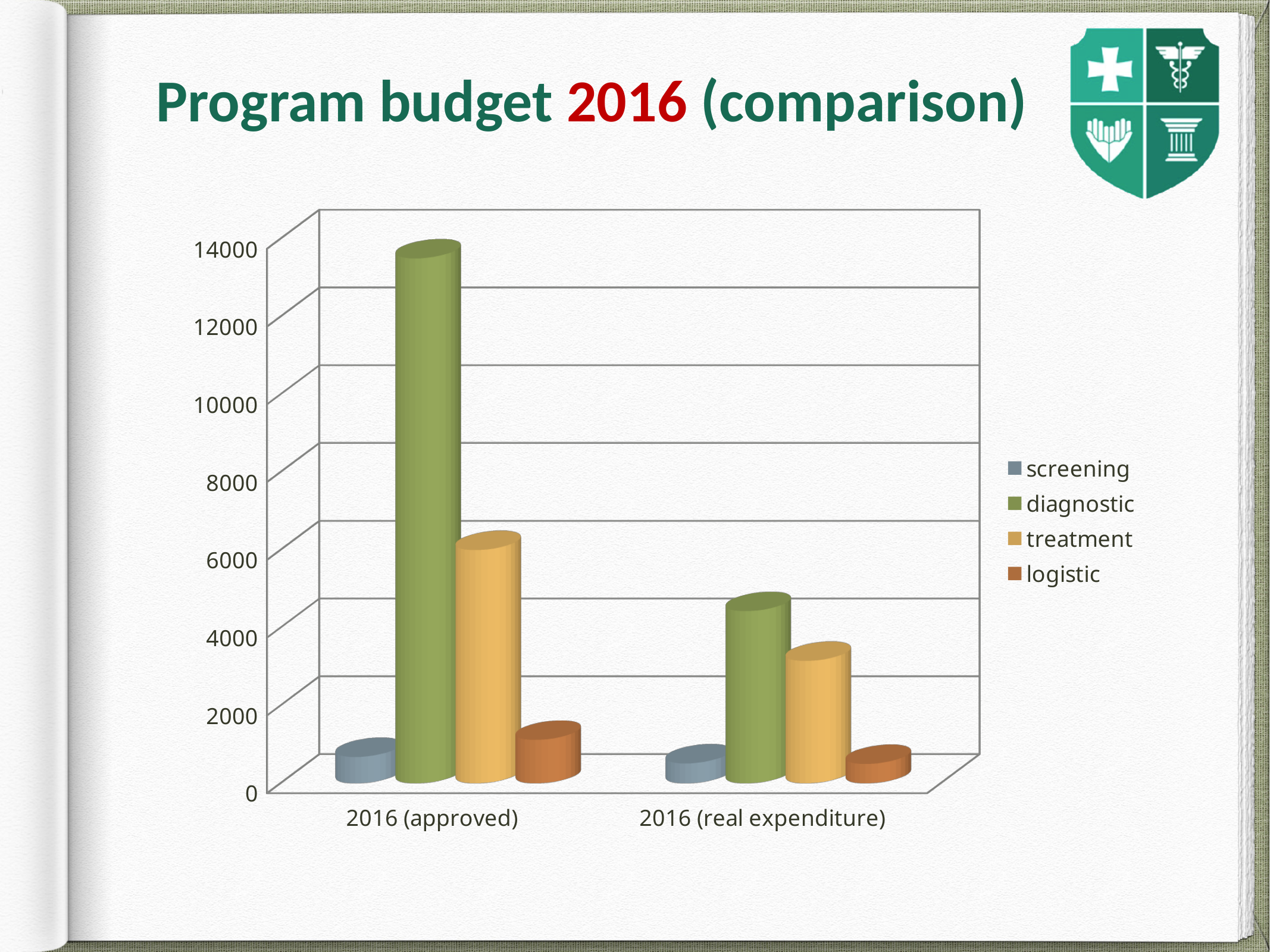
Which is larger: the diagnostic value for 2016 (approved) or for 2016 (real expenditure)? 2016 (approved) How many series does the legend list? 4 How many categories are shown on the x axis? 2 Is the value for diagnostic in 2016 (approved) greater or less than 12000? greater What is the title of the slide containing the chart? Program budget 2016 (comparison) Is the value for treatment in 2016 (approved) greater or less than 4000? greater Does the treatment value rise or fall from 2016 (approved) to 2016 (real expenditure)? fall Which series has the lowest value in the 2016 (approved) category? screening What kind of chart is shown on the slide? bar chart Is the value for diagnostic in 2016 (real expenditure) greater or less than 6000? less Which series has the highest value in the 2016 (approved) category? diagnostic